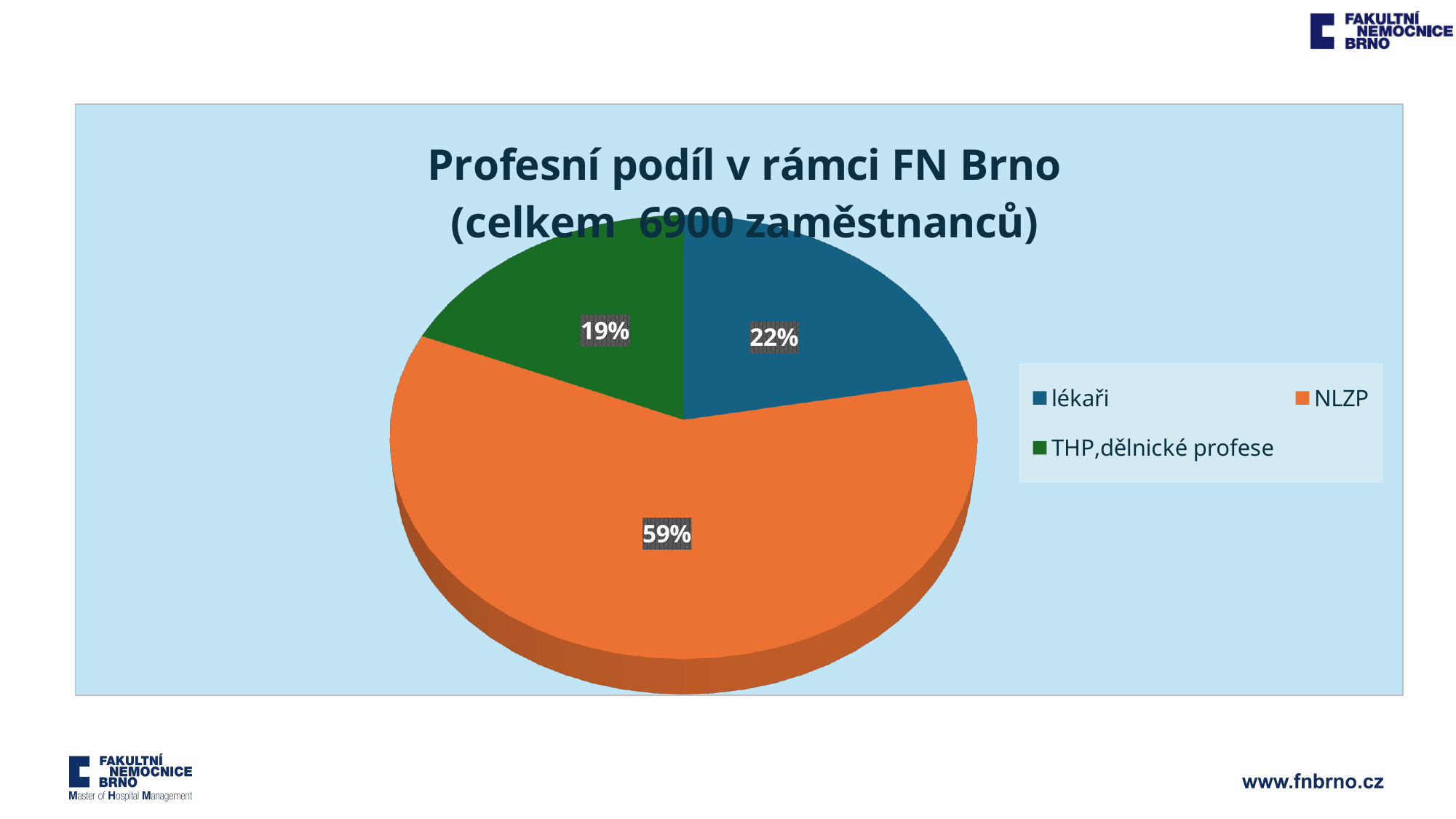
How many categories does the legend list? 3 Which slice is larger, lékaři or THP,dělnické profese? lékaři What is the difference in percentage points between the NLZP slice and the lékaři slice? 37 Which category has the smallest slice of the pie? THP,dělnické profese How many slices does the pie chart have? 3 What share of the pie does lékaři represent? 22% What share of the pie does THP,dělnické profese represent? 19% Which category has the largest slice of the pie? NLZP What is the title of the chart? Profesní podíl v rámci FN Brno (celkem 6900 zaměstnanců) What colour is the NLZP slice? orange What share of the pie does NLZP represent? 59% What type of chart is shown on the slide? pie chart